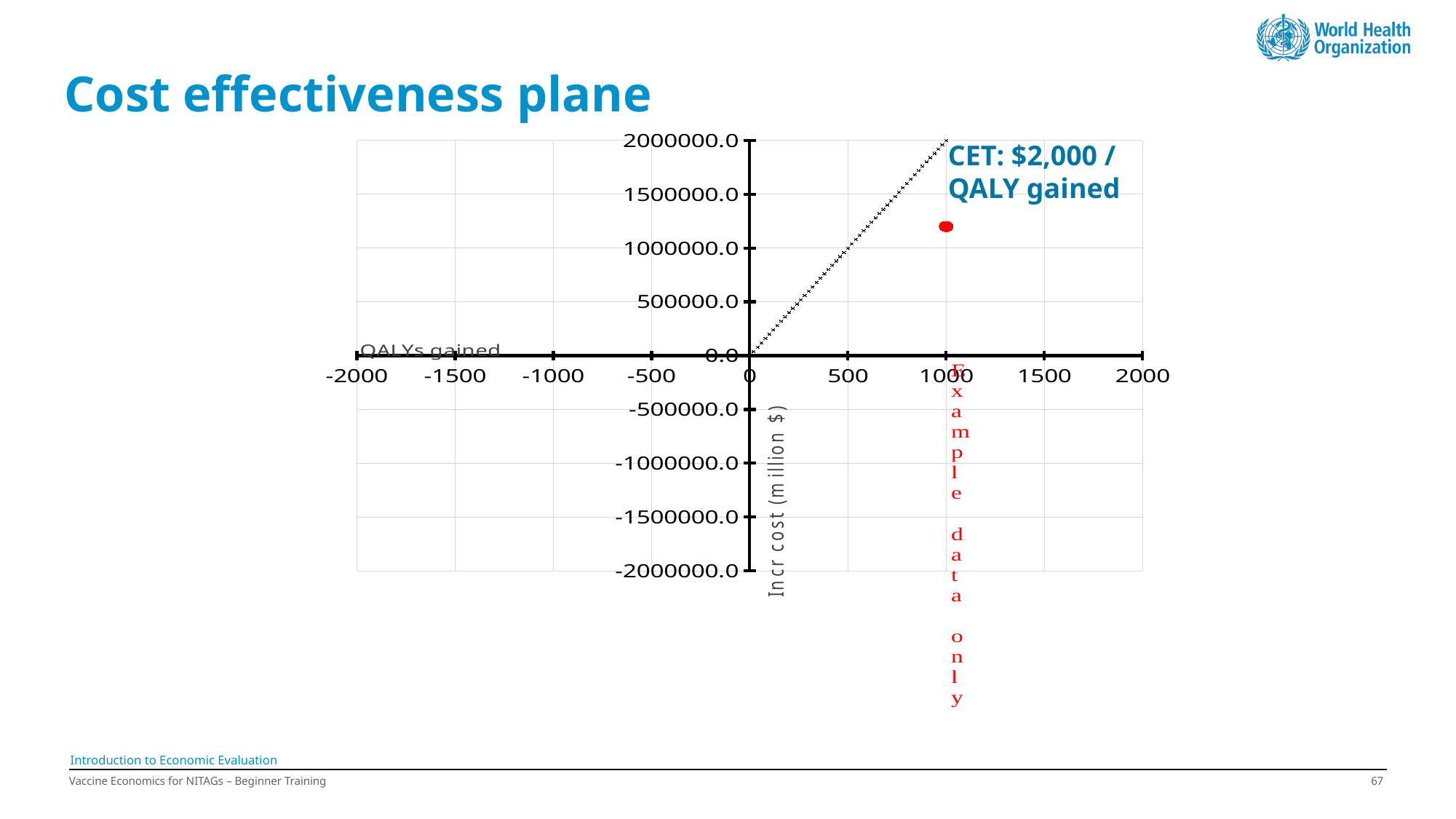
How many red data points are plotted on the chart? 1 Is the QALYs gained value of the red data point greater or less than 0? greater Is the incremental cost of the red data point greater or less than 1000000.0? greater What is the title of the vertical axis of the chart? Incr cost (million $) Is the red data point above or below the dotted CET line? below Does the dotted CET line rise or fall as QALYs gained increases? rises What is the cost-effectiveness threshold (CET) stated on the chart? $2,000 / QALY gained What is the QALYs gained value of the red data point? 1000 What kind of chart is shown on the slide? scatter chart What is the maximum value shown on the vertical axis? 2000000.0 What is the minimum value shown on the horizontal axis? -2000 Is the incremental cost of the red data point greater or less than 1500000.0? less